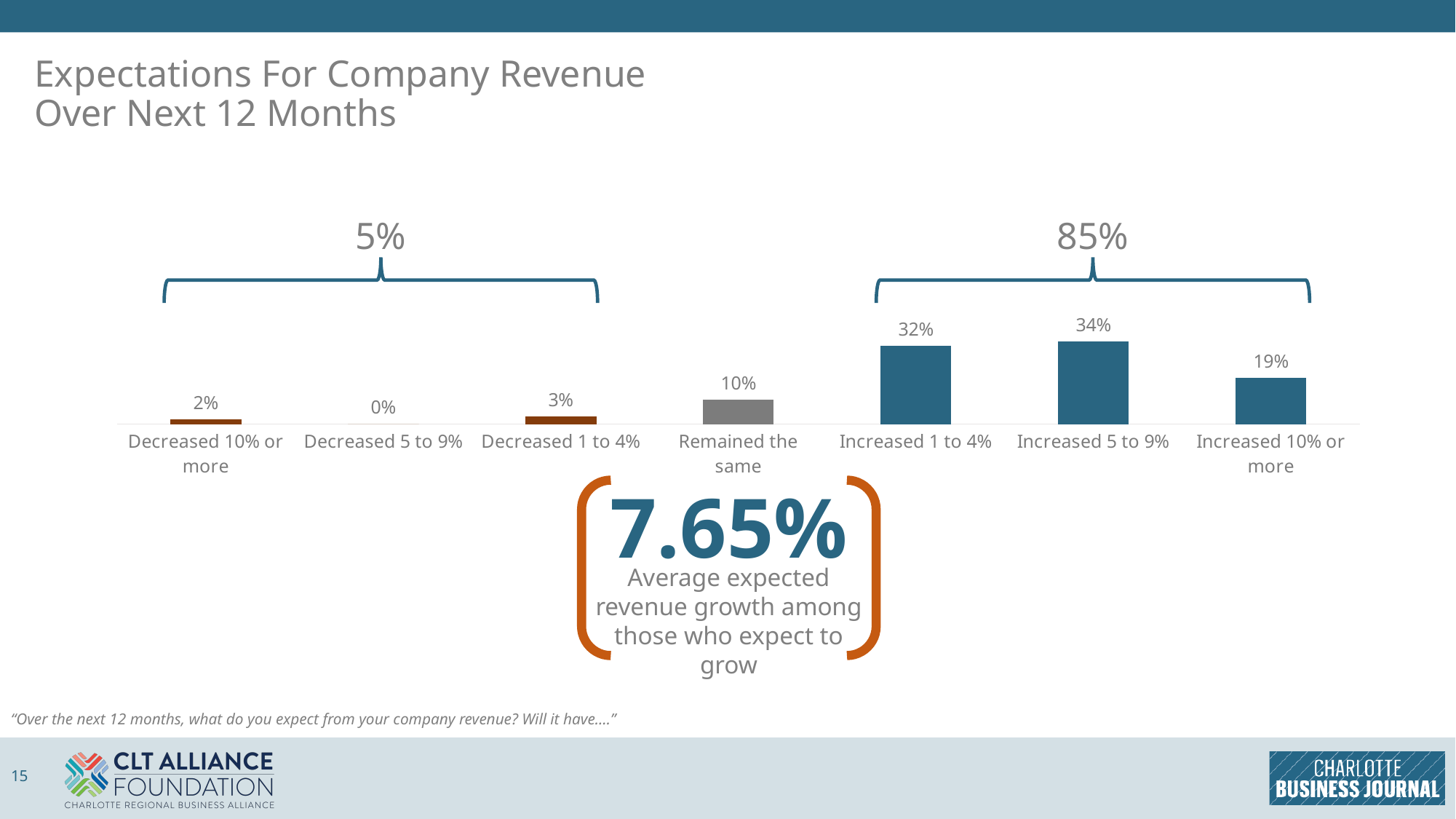
Which category has the lowest value? Decreased 5 to 9% What percentage of respondents expect revenue to have remained the same? 10% What is the difference between the values for Increased 1 to 4% and Increased 10% or more? 13% How many categories are shown on the x axis? 7 What is the total of the three 'Decreased' categories? 5% What is the average expected revenue growth among those who expect to grow, as shown in the callout? 7.65% What percentage of respondents expect revenue to have decreased 10% or more? 2% Which is larger, the value for Decreased 1 to 4% or the value for Remained the same? Remained the same What kind of chart is shown on the slide? Bar chart What is the combined share shown above the bracket over the three 'Increased' categories? 85% Which category has the highest value? Increased 5 to 9% What percentage of respondents expect revenue to have increased 5 to 9%? 34%